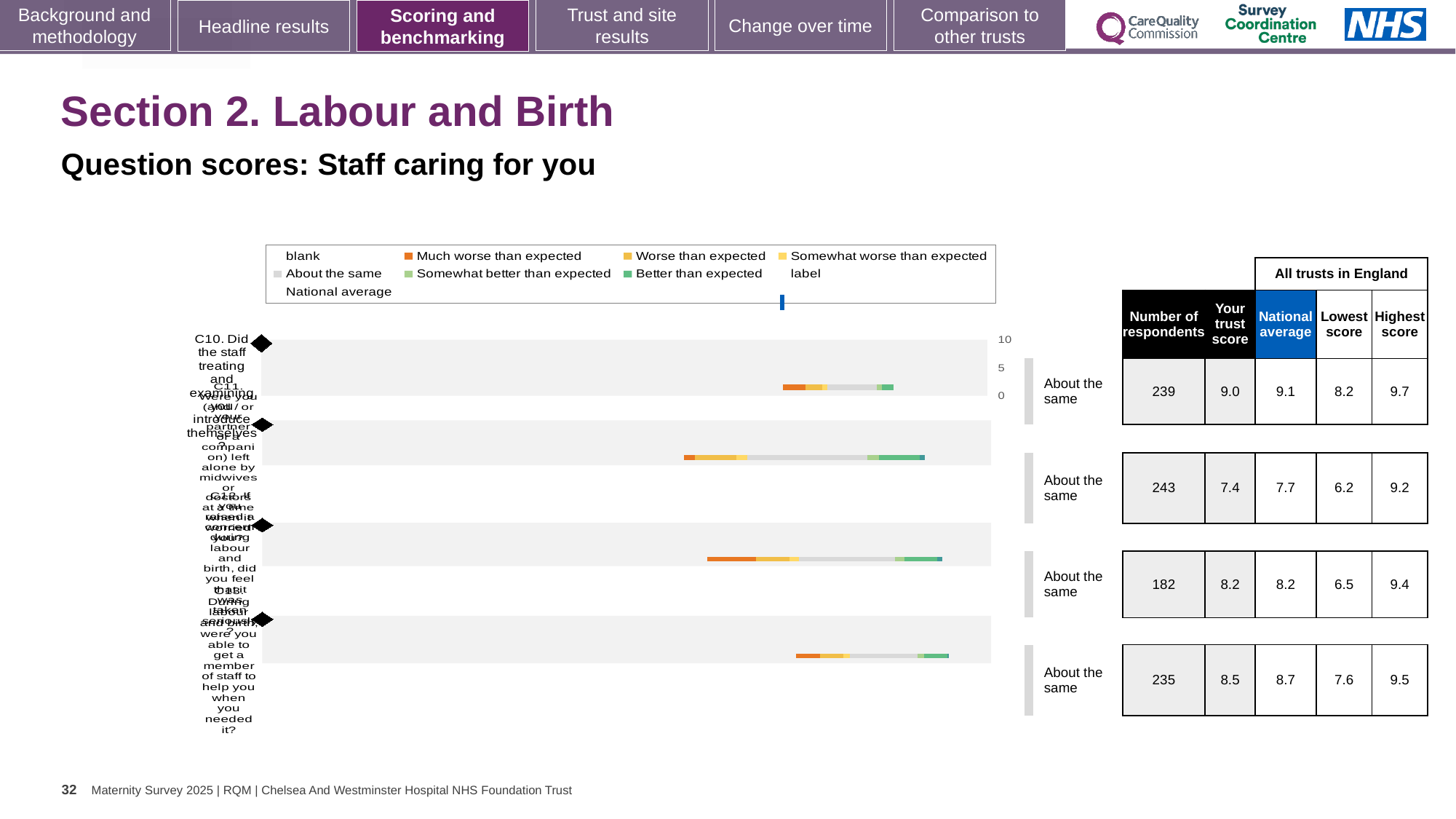
What is the 'Your trust score' for question C10? 9.0 What is the highest score among all trusts in England for question C13? 9.5 What kind of chart is shown on the slide? bar chart Which question has the highest 'Your trust score'? C10 Is the trust score for question C13 larger or smaller than the national average for C13? smaller What is the difference between the national average and the trust score for question C11? 0.3 What benchmark category is shown for question C12? About the same How many questions (categories) are plotted in the chart? 4 What is the national average for question C11? 7.7 Which legend entry is shown in orange? Much worse than expected What is the number of respondents for question C12? 182 Which question has the lowest 'Your trust score'? C11